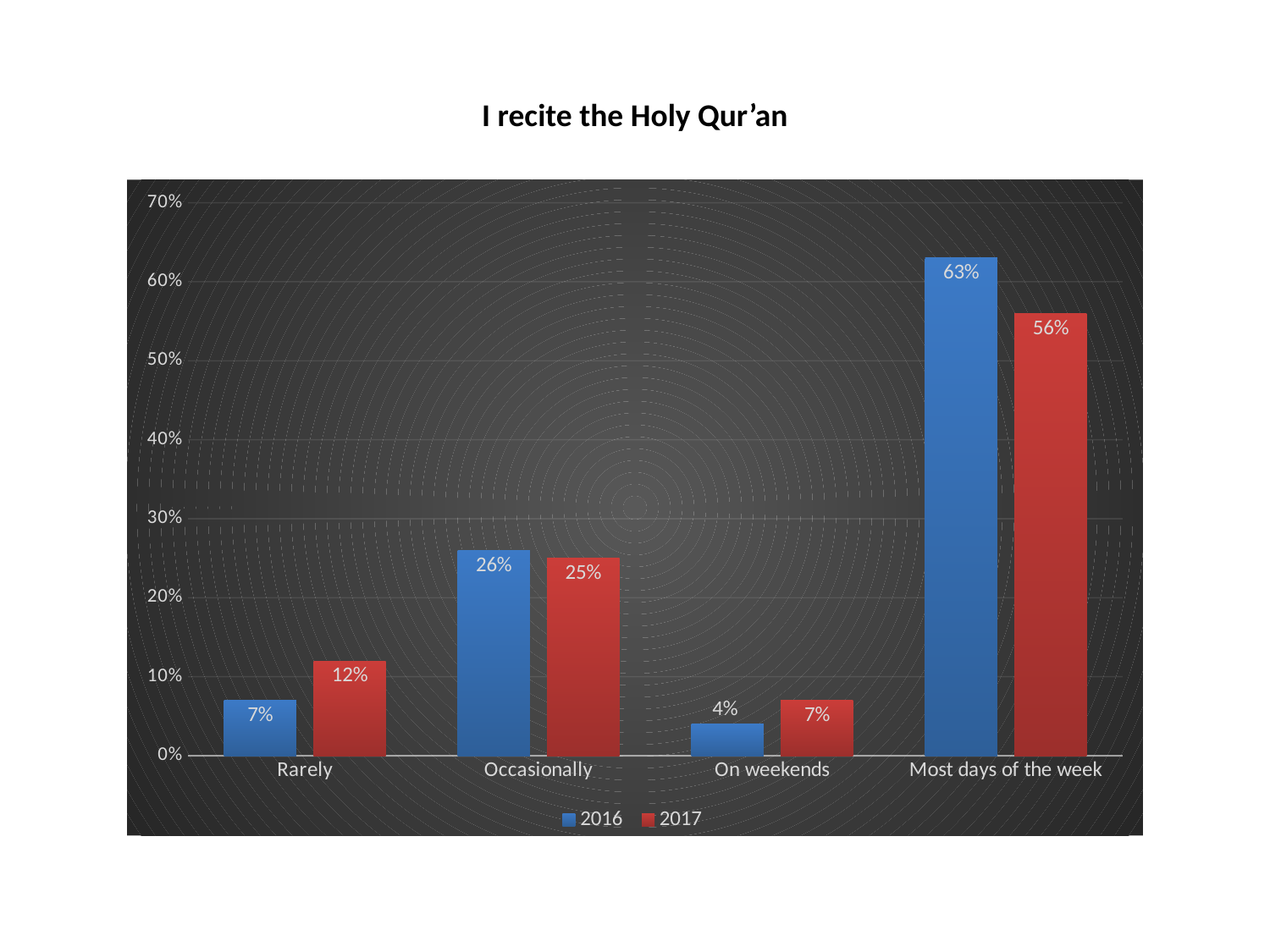
Which is larger for Rarely, the 2016 value or the 2017 value? 2017 Is the 2017 value for Occasionally greater or less than 30%? less What is the 2016 value for Rarely? 7% What kind of chart is shown? bar chart Which category has the lowest 2017 value? On weekends What is the 2016 value for On weekends? 4% What is the title of the chart? I recite the Holy Qur'an How many categories are shown on the x axis? 4 What is the difference between the 2016 and 2017 values for Most days of the week? 7% How many series does the legend list? 2 Which category has the highest 2016 value? Most days of the week What is the 2017 value for Most days of the week? 56%